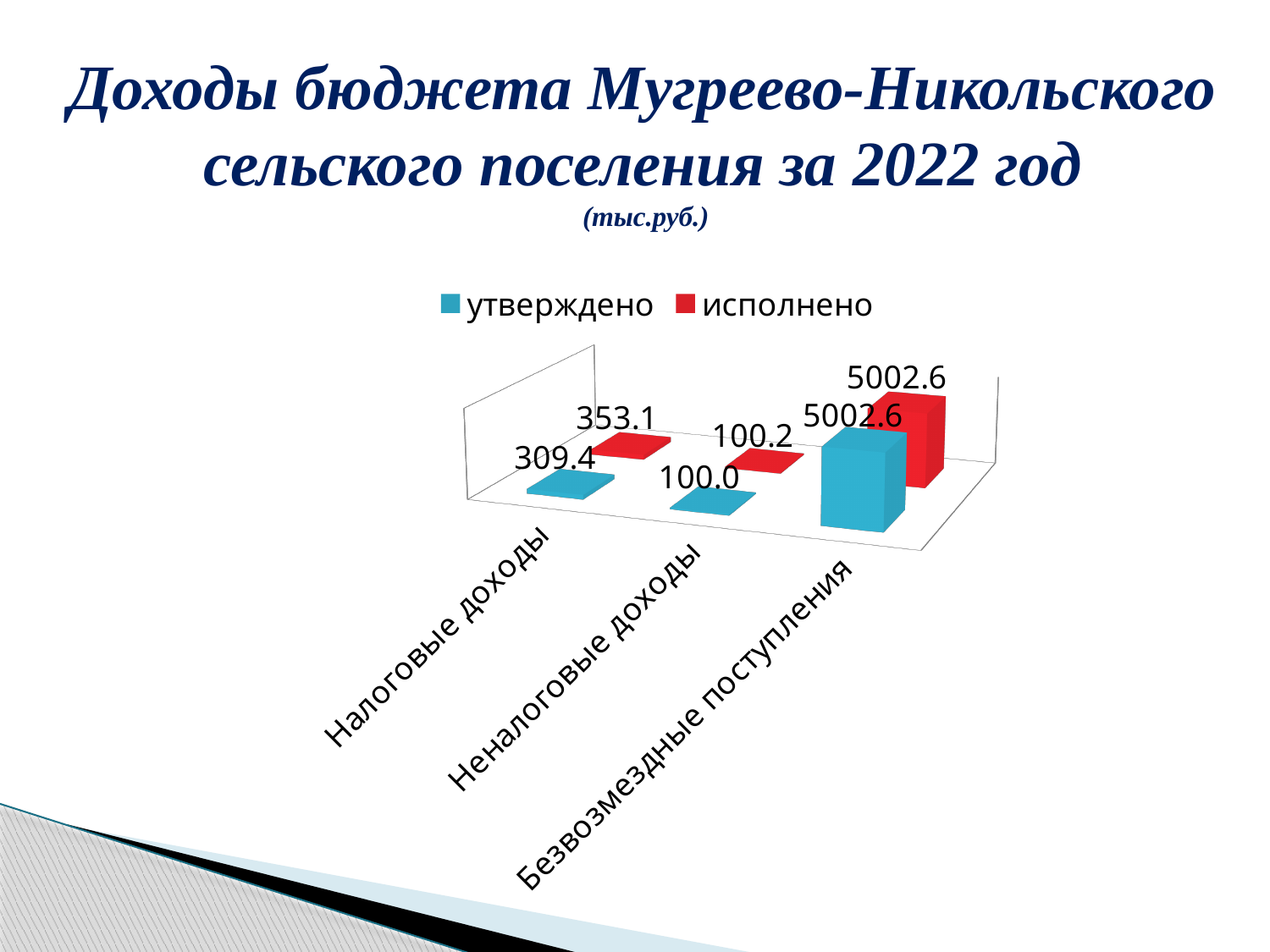
What is the утверждено value for Неналоговые доходы? 100.0 What is the исполнено value for Безвозмездные поступления? 5002.6 What kind of chart is shown on the slide? bar chart How many series does the legend list? 2 For Налоговые доходы, which is larger: утверждено or исполнено? исполнено What is the исполнено value for Налоговые доходы? 353.1 What is the исполнено value for Неналоговые доходы? 100.2 Which category has the highest утверждено value? Безвозмездные поступления What is the difference between the исполнено and утверждено values for Налоговые доходы? 43.7 Which category has the lowest исполнено value? Неналоговые доходы What is the утверждено value for Налоговые доходы? 309.4 How many categories are shown on the x axis? 3